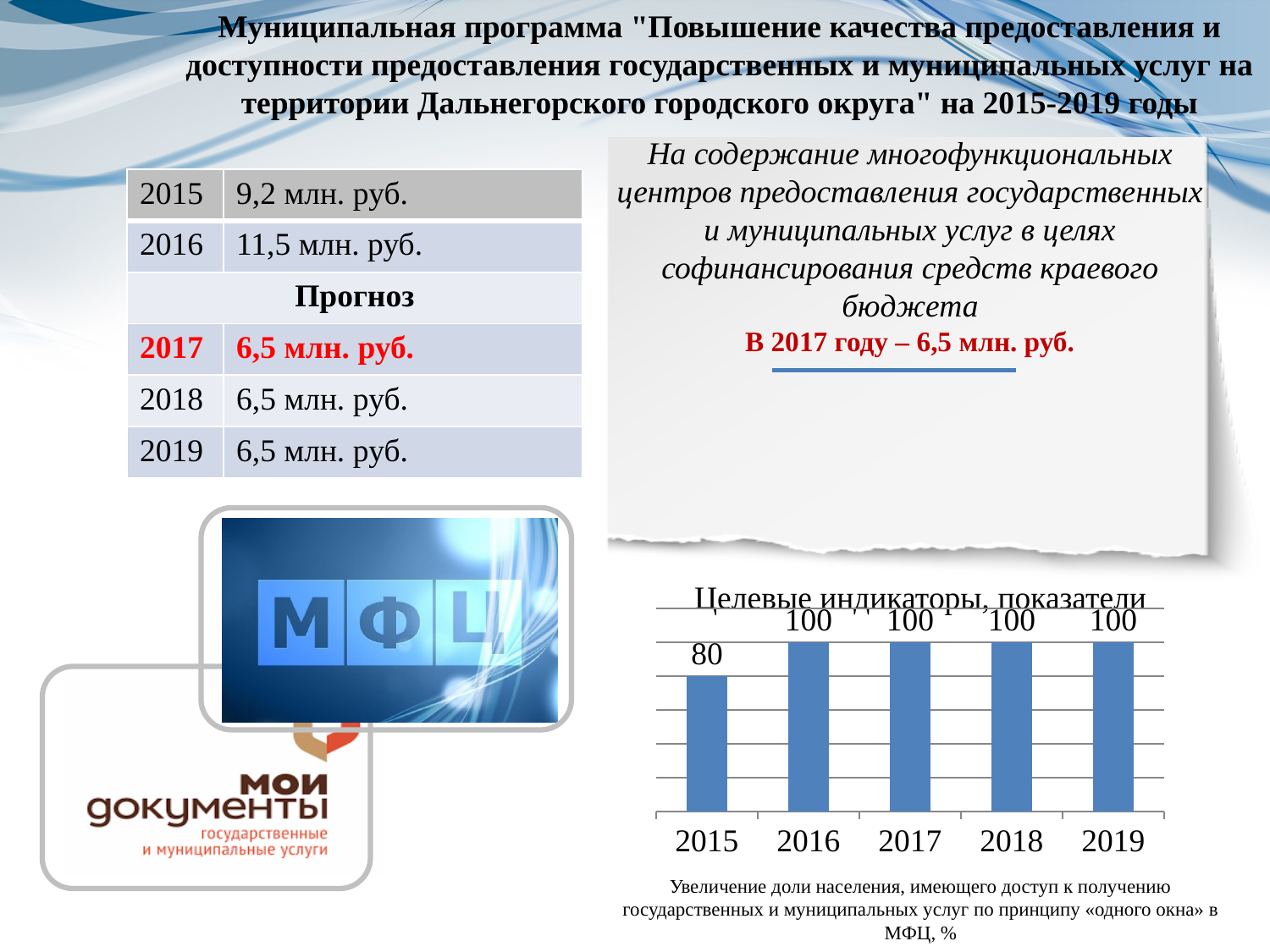
Which year has the lowest value in the chart "Целевые индикаторы, показатели"? 2015 What is the value for 2015 in the chart "Целевые индикаторы, показатели"? 80 How many years are shown on the x axis of the chart "Целевые индикаторы, показатели"? 5 What is the value for 2017 in the chart "Целевые индикаторы, показатели"? 100 What kind of chart is "Целевые индикаторы, показатели"? bar chart How many years in the chart "Целевые индикаторы, показатели" have a value of 100? 4 Which is larger in the chart "Целевые индикаторы, показатели": the value for 2015 or the value for 2018? 2018 What is the value for 2019 in the chart "Целевые индикаторы, показатели"? 100 What is the title of the bar chart on the slide? Целевые индикаторы, показатели Do the values in the chart "Целевые индикаторы, показатели" rise or fall from 2015 to 2016? rise What is the difference between the values for 2016 and 2015 in the chart "Целевые индикаторы, показатели"? 20 What colour are the bars in the chart "Целевые индикаторы, показатели"? blue